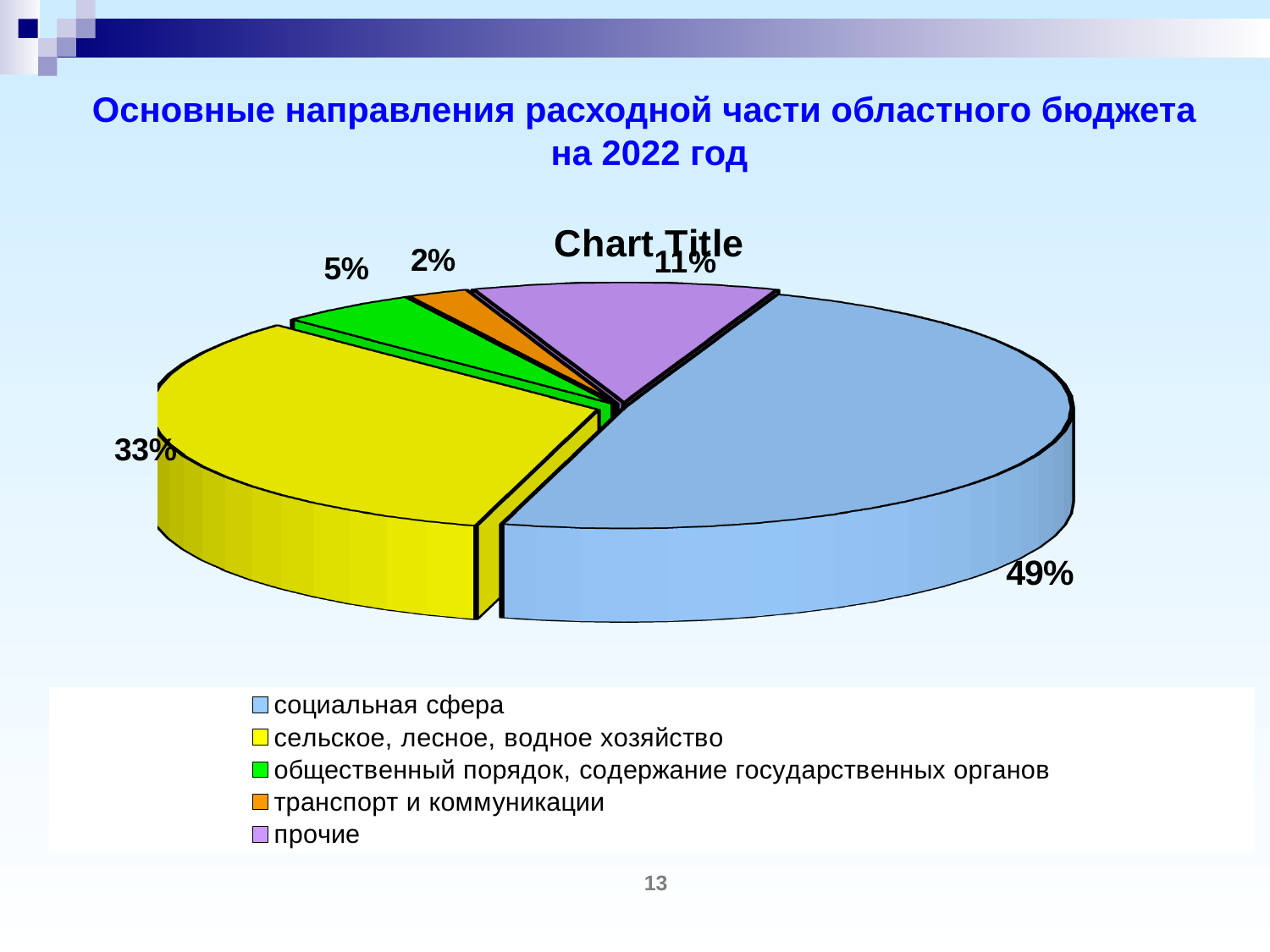
What is the difference in percentage points between "социальная сфера" and "сельское, лесное, водное хозяйство"? 16 Which is larger: the slice for "прочие" or the slice for "общественный порядок, содержание государственных органов"? прочие What share of the pie does "сельское, лесное, водное хозяйство" have? 33% What colour is the slice for "сельское, лесное, водное хозяйство"? yellow What share of the pie does "общественный порядок, содержание государственных органов" have? 5% What share of the pie does "прочие" have? 11% Which category has the largest slice of the pie? социальная сфера Which category has the smallest slice of the pie? транспорт и коммуникации How many categories does the legend list? 5 What share of the pie does "транспорт и коммуникации" have? 2% What share of the pie does "социальная сфера" have? 49% What kind of chart is shown on the slide? pie chart